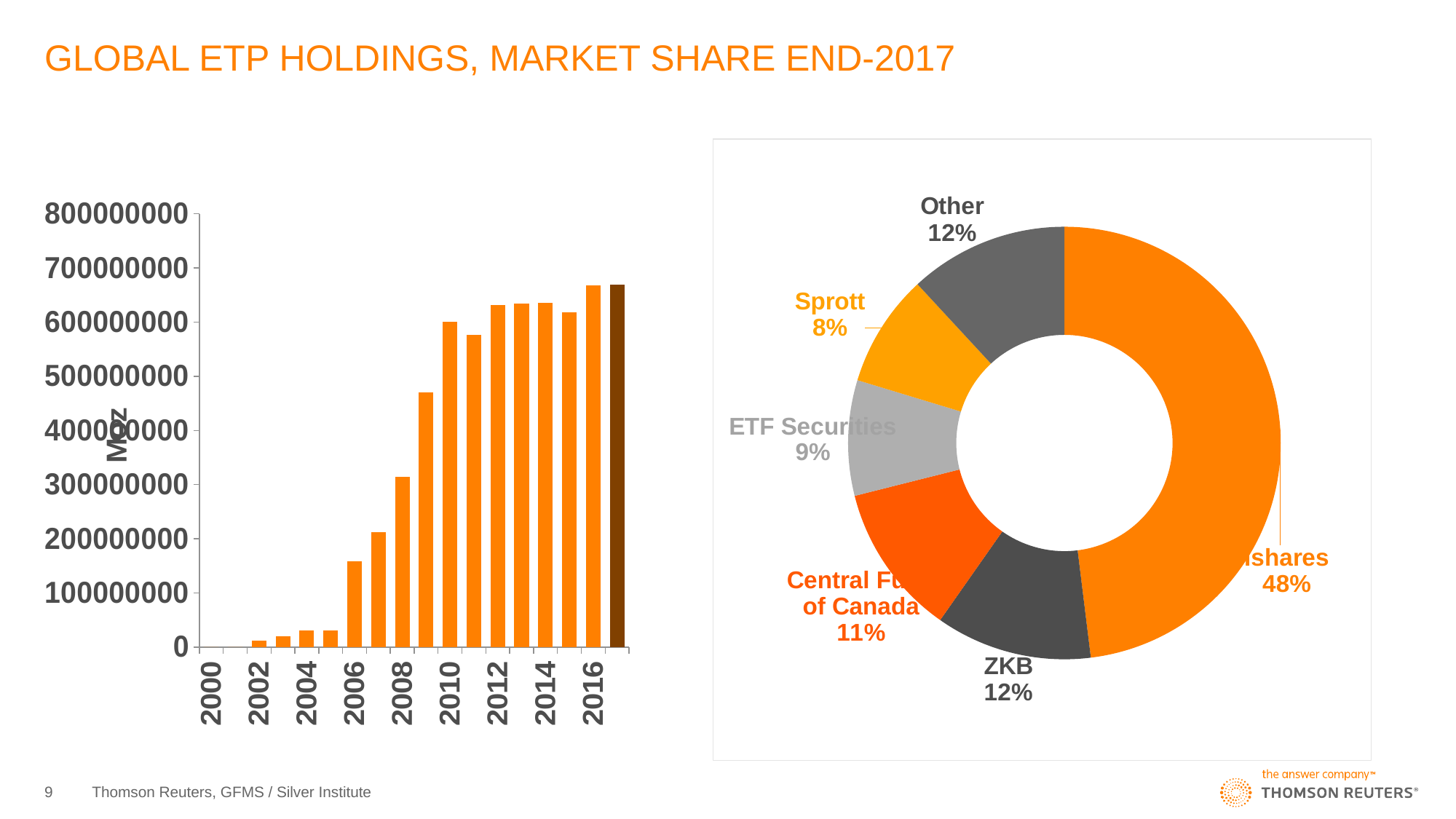
In the pie chart on the right, what is the market share of iShares? 48% In the pie chart on the right, which slice is the largest? iShares In the pie chart on the right, what is the market share of ETF Securities? 9% In the pie chart on the right, what is the difference between the shares of iShares and ZKB? 36% In the bar chart on the left, is the value for 2006 greater or less than 200000000? less What kind of chart is shown on the right side of the slide? doughnut chart In the pie chart on the right, which named provider has the smallest share? Sprott In the bar chart on the left, is the value for 2009 greater or less than 400000000? greater In the pie chart on the right, how many slices are there? 6 In the bar chart on the left, do the values generally rise or fall from 2000 to 2017? rise In the pie chart on the right, which has the larger share, Central Fund of Canada or Sprott? Central Fund of Canada What kind of chart is shown on the left side of the slide? bar chart